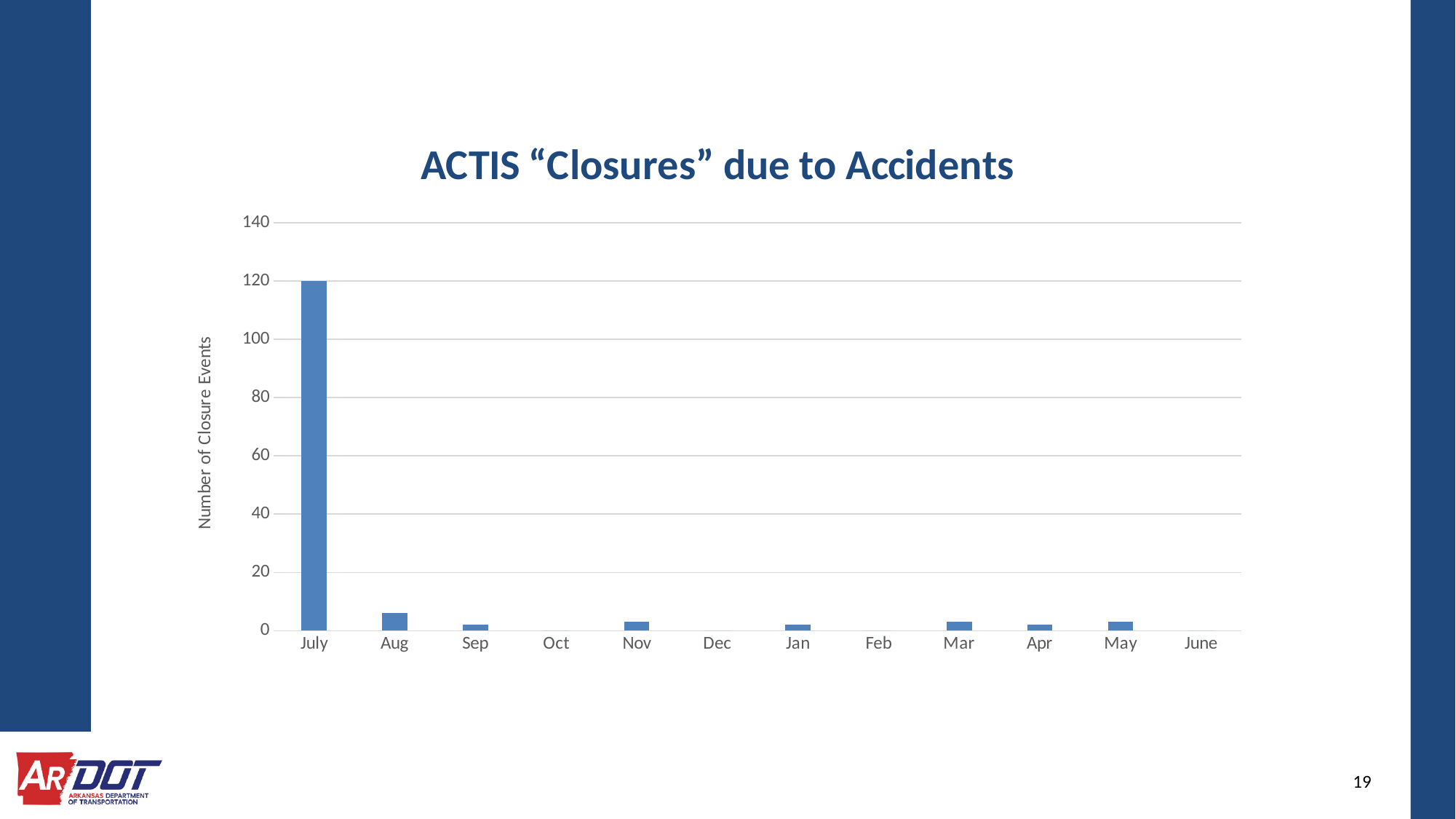
What is the number of closure events for July? 120 What is the title of the chart? ACTIS "Closures" due to Accidents Is the value for July greater or less than 100? greater Which month is the first category on the x axis? July Which month has more closure events, Aug or Sep? Aug Is the value for Aug greater or less than 20? less What type of chart is shown on the slide? bar chart What is the label on the vertical axis of the chart? Number of Closure Events Which month has the highest number of closure events? July Which month has more closure events, July or Aug? July Is the value for Nov greater or less than 20? less How many months are shown along the x axis of the chart? 12